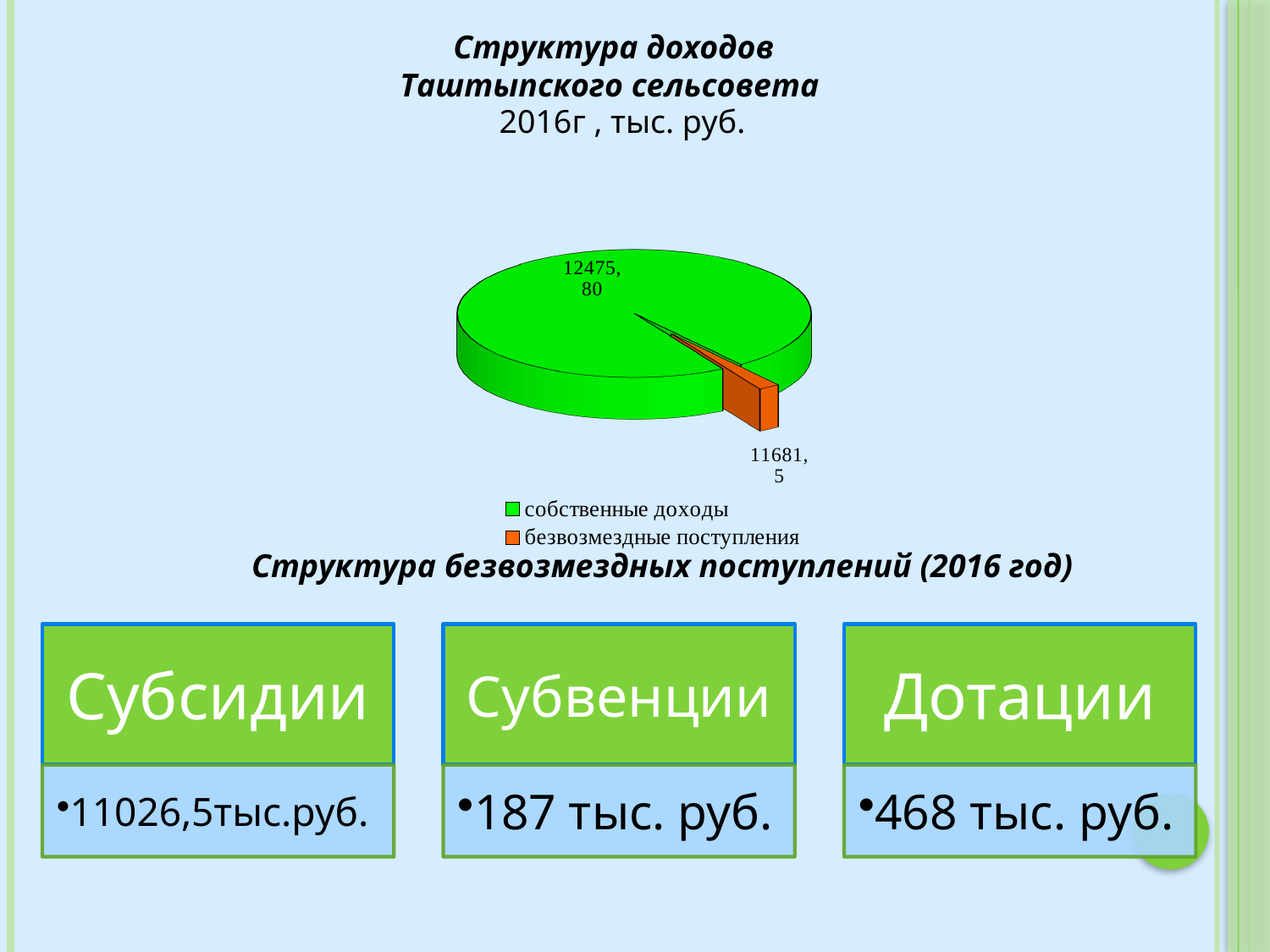
What colour is the собственные доходы slice in the pie chart? green How many entries does the legend of the pie chart list? 2 What colour is the безвозмездные поступления slice in the pie chart? orange What kind of chart is shown on the slide? pie chart Which slice of the pie chart is the largest? собственные доходы What is the difference between the labelled values for собственные доходы and безвозмездные поступления? 794,3 How many slices does the pie chart have? 2 Which slice of the pie chart is the smallest? безвозмездные поступления What value is labelled on the pie chart for собственные доходы? 12475,80 Which is larger on the pie chart, собственные доходы or безвозмездные поступления? собственные доходы What value is labelled on the pie chart for безвозмездные поступления? 11681,5